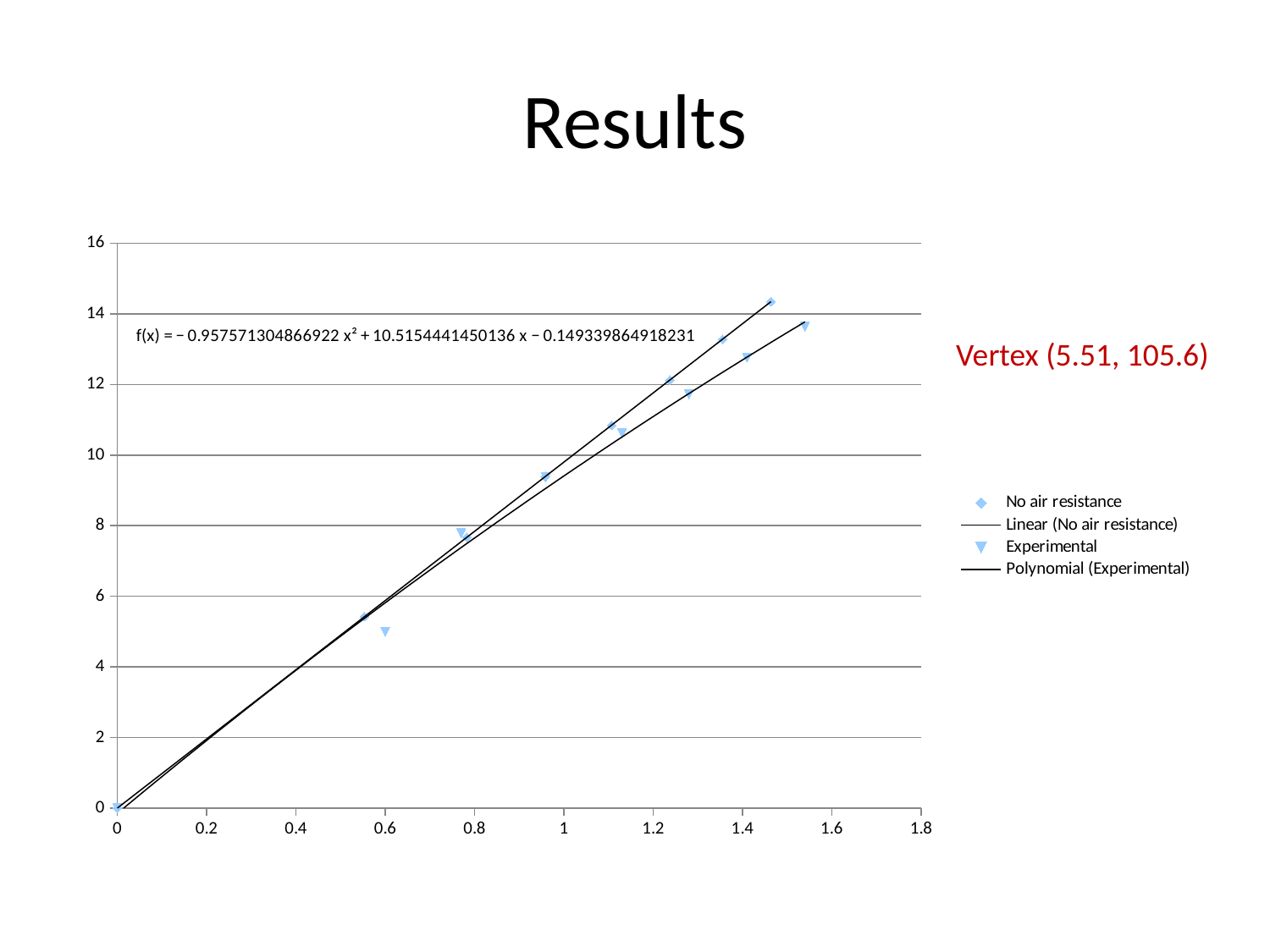
Do the plotted values rise or fall as x increases along the x axis? rise Is the No air resistance value near x = 1.35 greater or less than 12? greater Is the Experimental value at x = 0.6 greater or less than 6? less Which legend entry corresponds to the thicker black trendline? Polynomial (Experimental) Is the No air resistance value near x = 0.96 greater or less than 10? less What kind of chart is shown on the slide? scatter chart Which series reaches a higher maximum y value, No air resistance or Experimental? No air resistance What is the y value of the Experimental point at x = 0? 0 What is the title of the slide containing the chart? Results How many entries does the chart legend list? 4